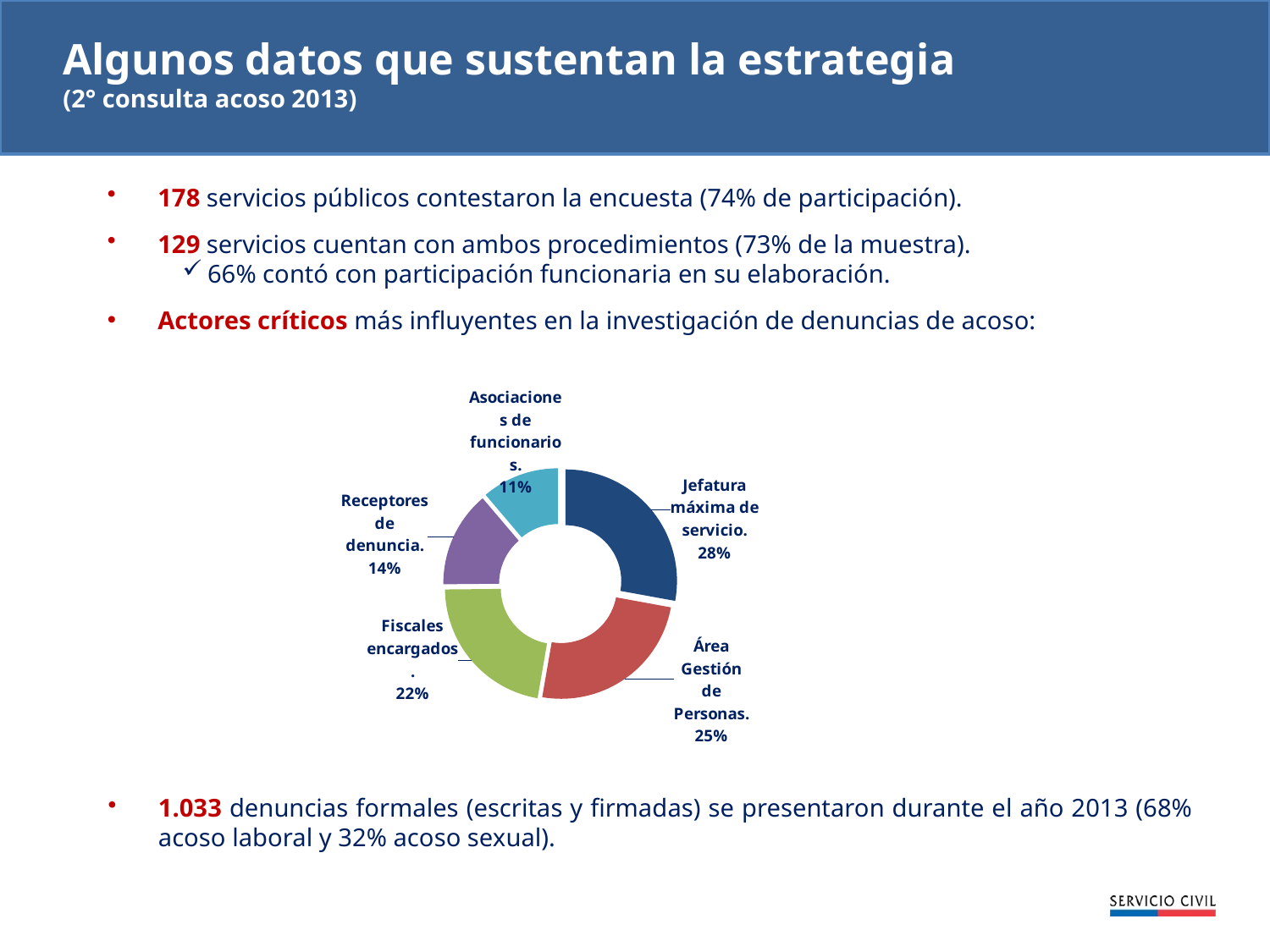
What percentage is shown for Fiscales encargados? 22% How many categories are shown in the chart? 5 What percentage is shown for Jefatura máxima de servicio? 28% What percentage is shown for Asociaciones de funcionarios? 11% What percentage is shown for Receptores de denuncia? 14% What kind of chart is shown on the slide? Doughnut chart Which category has the smallest share of the chart? Asociaciones de funcionarios What colour is the slice for Área Gestión de Personas? Red What percentage is shown for Área Gestión de Personas? 25% Which is larger, the share for Fiscales encargados or the share for Receptores de denuncia? Fiscales encargados What is the difference in percentage points between Jefatura máxima de servicio and Asociaciones de funcionarios? 17 Which category has the largest share of the chart? Jefatura máxima de servicio